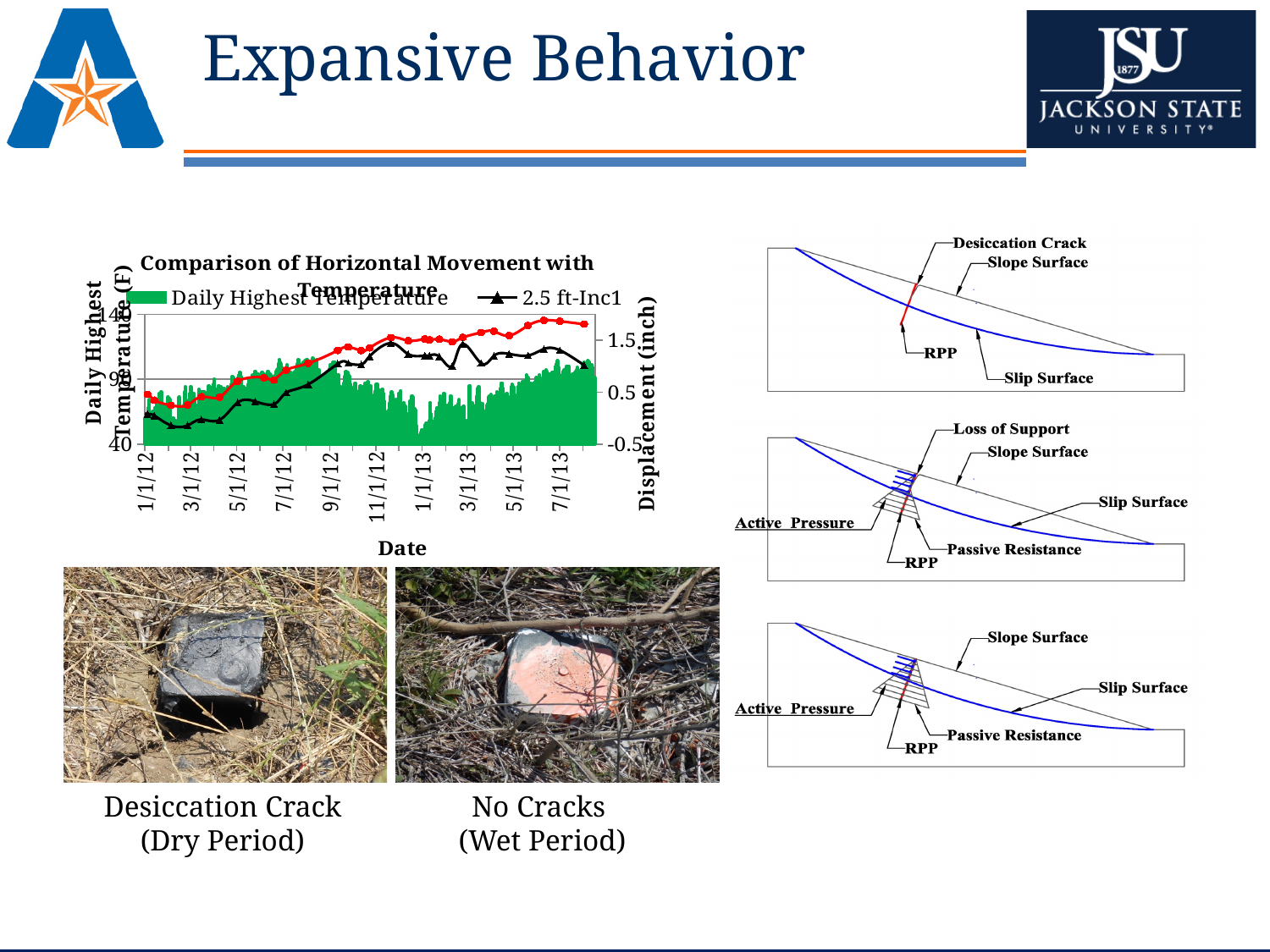
Which is larger for the 2.5 ft-Inc1 series: the displacement at 1/1/12 or at 1/1/13? 1/1/13 What kind of chart is used to plot the 2.5 ft-Inc1 series? line chart Is the Daily Highest Temperature around 7/1/12 greater or less than 90 F? greater Is the Daily Highest Temperature around 1/1/12 greater or less than 90 F? less What is the label of the right-hand vertical axis? Displacement (inch) Is the 2.5 ft-Inc1 displacement at 1/1/12 greater or less than 0.5 inch? less How many series does the chart legend list? 2 What is the title of the chart? Comparison of Horizontal Movement with Temperature How many date labels are shown along the x axis? 10 Does the 2.5 ft-Inc1 displacement generally rise or fall from 1/1/12 to 7/1/13? rise